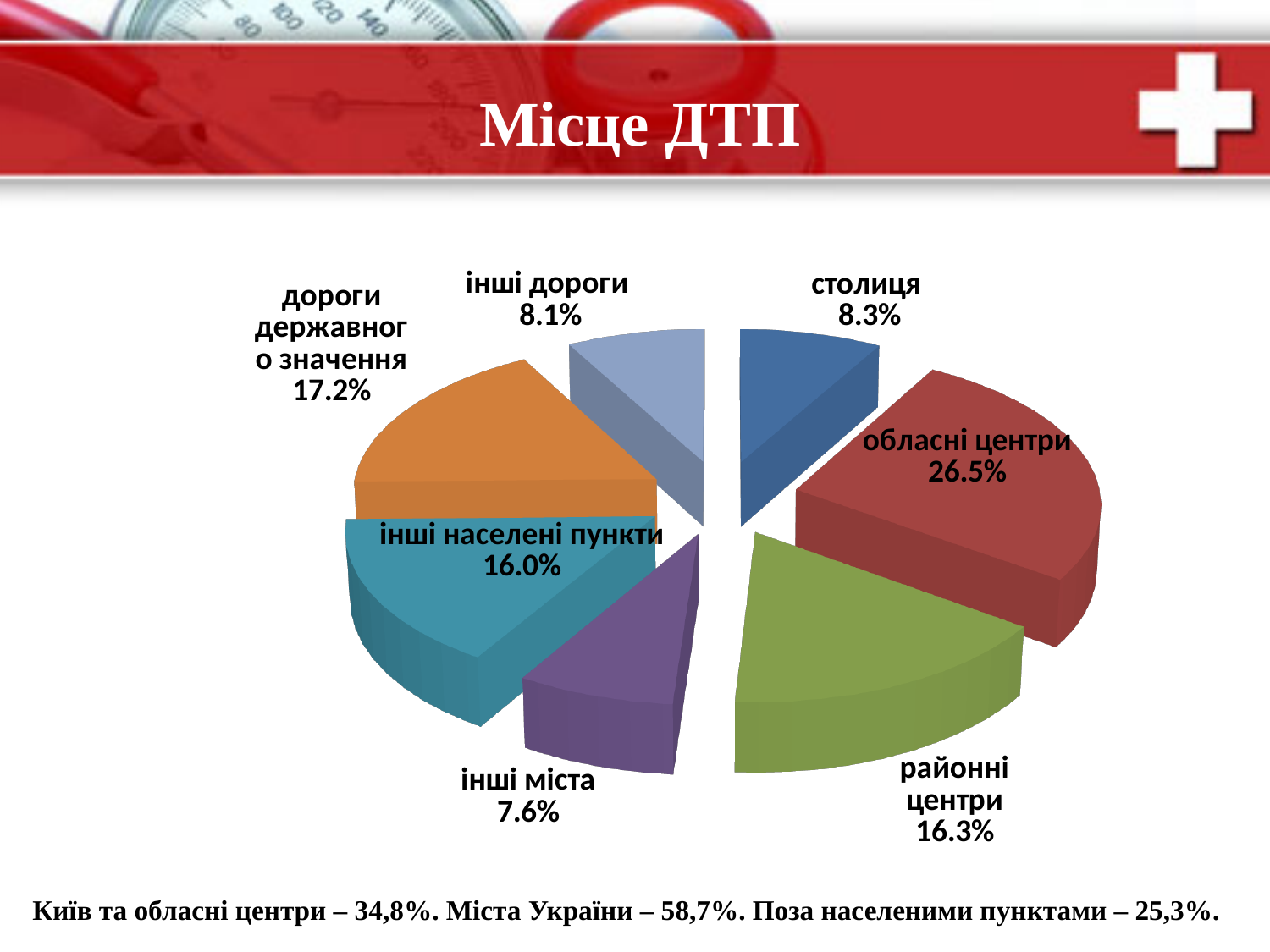
What is the share for інші міста? 7.6% Which is larger, the share for дороги державного значення or the share for інші населені пункти? дороги державного значення What is the title of the chart on the slide? Місце ДТП How many categories are shown in the pie chart? 7 Which category has the smallest slice of the pie? інші міста What is the share for столиця? 8.3% What kind of chart is shown on the slide? pie chart What is the share for обласні центри? 26.5% What is the share for дороги державного значення? 17.2% Which category has the largest slice of the pie? обласні центри What is the difference between the shares for столиця and інші дороги? 0.2% What is the difference between the shares for обласні центри and районні центри? 10.2%